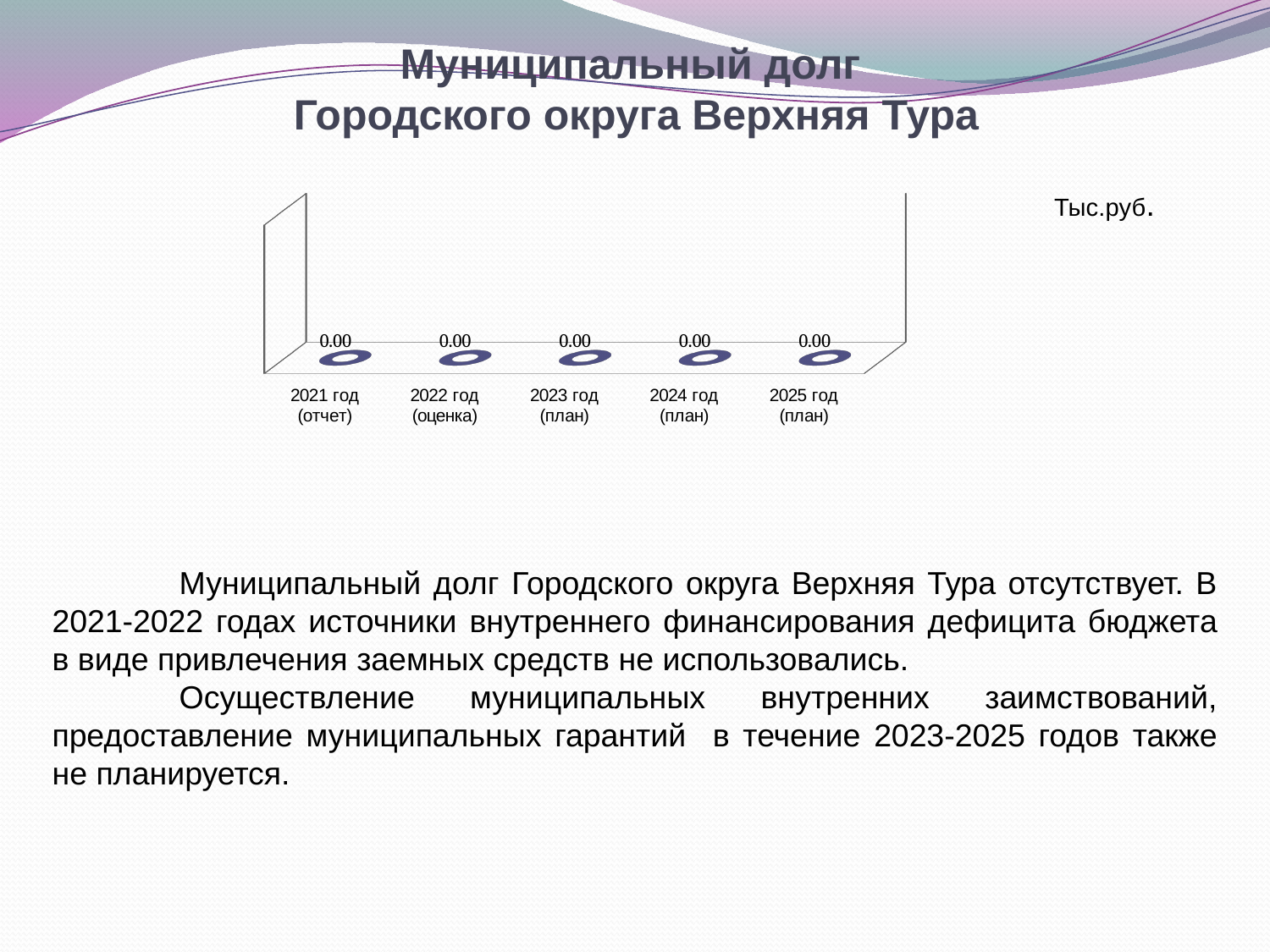
What is the value for 2024 год (план)? 0.00 What is the difference between the values for 2025 год (план) and 2021 год (отчет)? 0.00 What unit of measurement is indicated next to the chart? Тыс.руб. What is the value for 2021 год (отчет)? 0.00 Do the values rise, fall, or stay the same from 2021 год to 2025 год? stay the same How many categories are shown on the x axis of the chart? 5 What is the title of the slide containing the chart? Муниципальный долг Городского округа Верхняя Тура What is the value for 2025 год (план)? 0.00 What kind of chart is shown on the slide? bar chart What is the value for 2022 год (оценка)? 0.00 What is the value for 2023 год (план)? 0.00